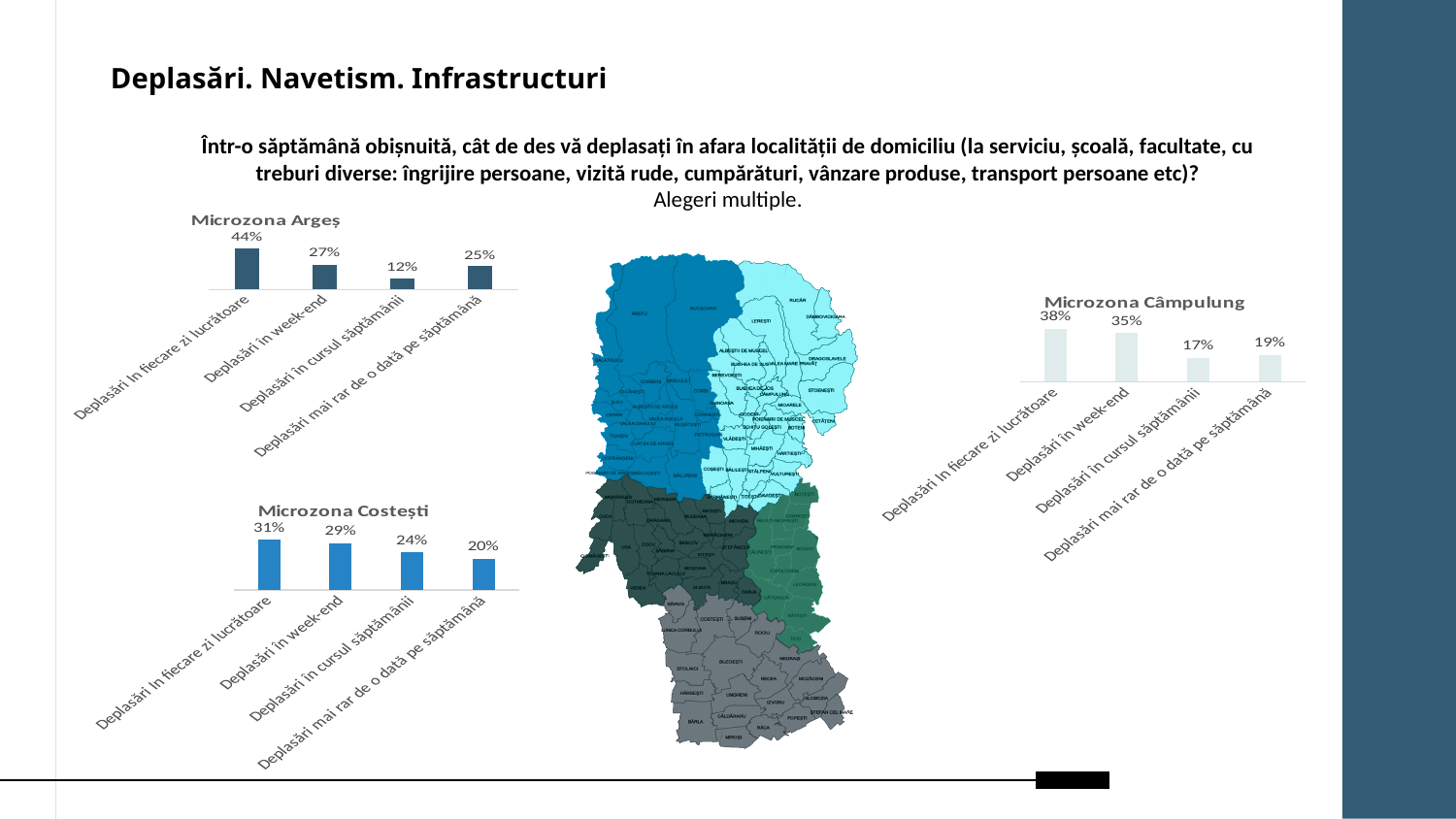
In the Microzona Argeș chart, what is the difference between "Deplasări în week-end" and "Deplasări mai rar de o dată pe săptămână"? 2% In the Microzona Costești chart, what is the difference between "Deplasări în fiecare zi lucrătoare" and "Deplasări mai rar de o dată pe săptămână"? 11% In the Microzona Argeș chart, which category has the lowest value? Deplasări în cursul săptămânii In the Microzona Câmpulung chart, which is larger: "Deplasări în cursul săptămânii" or "Deplasări mai rar de o dată pe săptămână"? Deplasări mai rar de o dată pe săptămână In the Microzona Argeș chart, what is the value for "Deplasări în fiecare zi lucrătoare"? 44% In the Microzona Costești chart, what is the value for "Deplasări în cursul săptămânii"? 24% What type of chart is the Microzona Costești chart? Bar chart How many categories does the Microzona Argeș chart show? 4 In the Microzona Costești chart, which category has the highest value? Deplasări în fiecare zi lucrătoare In the Microzona Câmpulung chart, what is the value for "Deplasări în week-end"? 35% In the Microzona Câmpulung chart, which category has the lowest value? Deplasări în cursul săptămânii How many bar charts are shown on the slide? 3